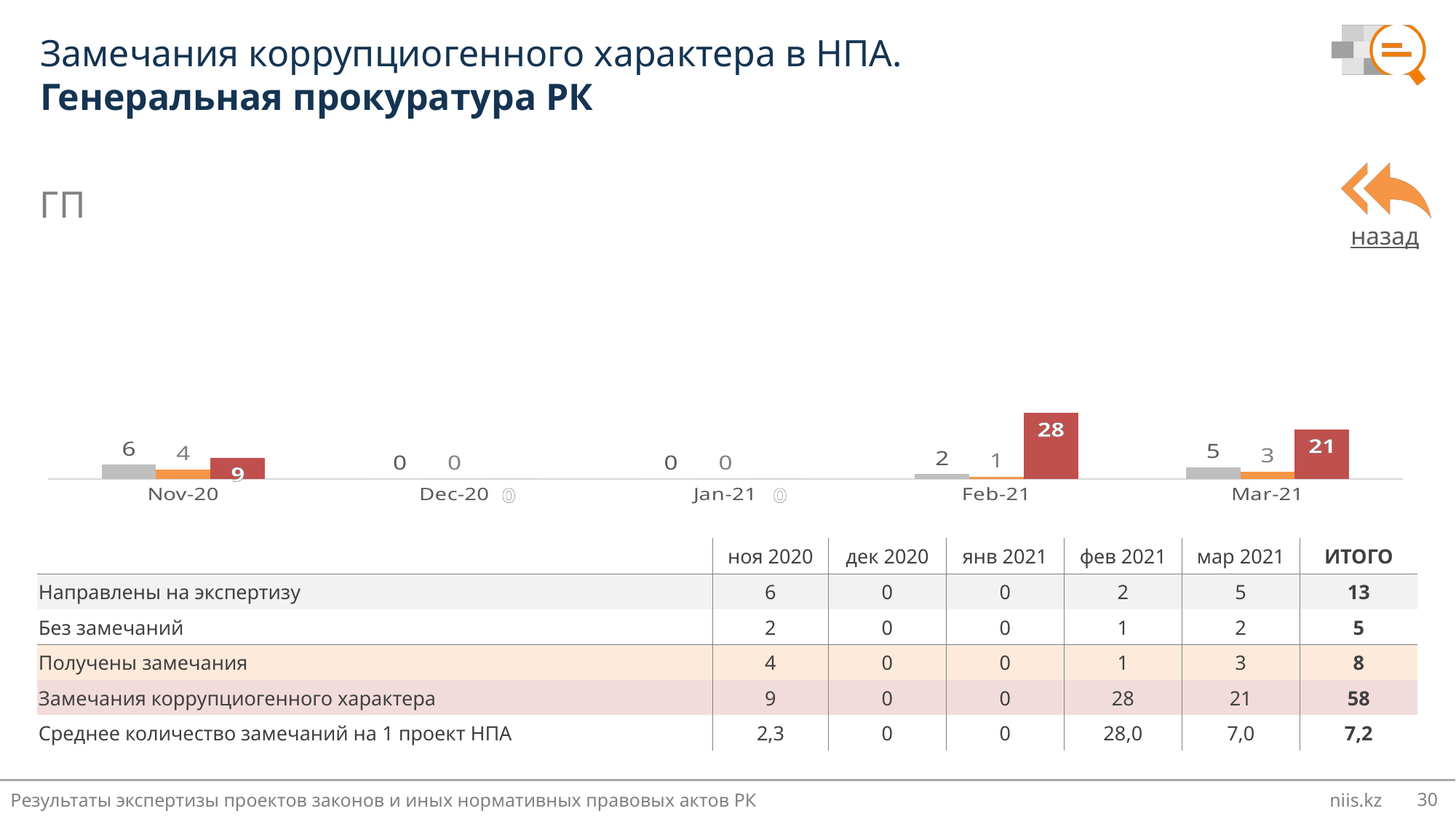
What kind of chart is shown on the slide? bar chart What is the value of the orange bar for Mar-21? 3 Which months show a value of 0 for the grey bar? Dec-20 and Jan-21 What is the value of the grey bar for Feb-21? 2 In which month is the grey bar highest? Nov-20 How many categories (months) are shown on the x axis of the chart? 5 What is the value of the red bar for Mar-21? 21 What is the value of the red bar for Feb-21? 28 What is the value of the grey bar for Nov-20? 6 In which month is the red bar highest? Feb-21 What is the difference between the red bar values for Feb-21 and Mar-21? 7 Which is larger: the red bar for Nov-20 or the red bar for Mar-21? Mar-21